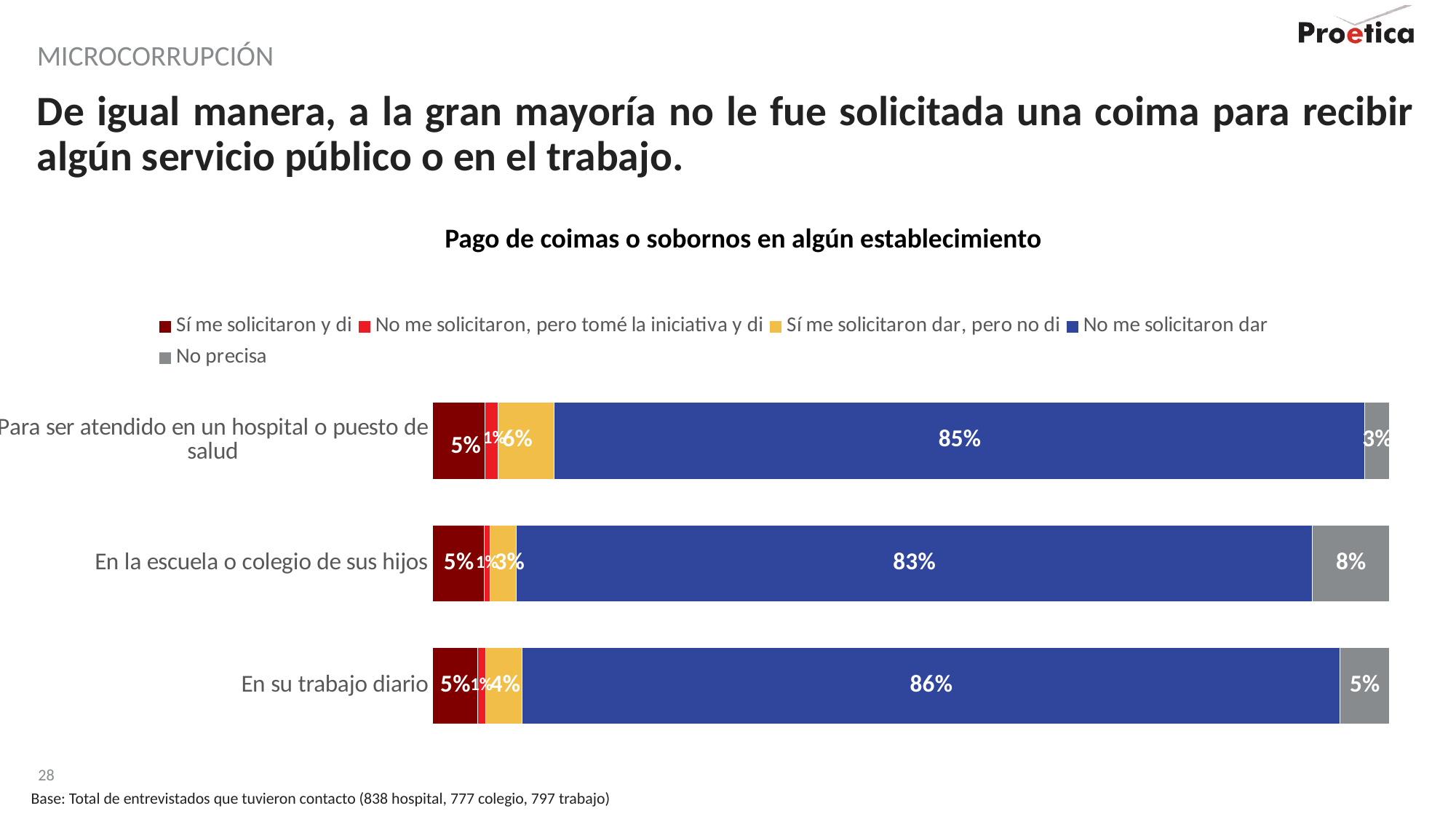
What is the title of the chart? Pago de coimas o sobornos en algún establecimiento What is the value of "No me solicitaron dar" for "Para ser atendido en un hospital o puesto de salud"? 85% What is the value of "No precisa" for "En la escuela o colegio de sus hijos"? 8% Which category has the lowest value for "No precisa"? Para ser atendido en un hospital o puesto de salud What is the difference between the "No me solicitaron dar" values for "En su trabajo diario" and "En la escuela o colegio de sus hijos"? 3% Which is larger: the "Sí me solicitaron dar, pero no di" value for "Para ser atendido en un hospital o puesto de salud" or for "En la escuela o colegio de sus hijos"? Para ser atendido en un hospital o puesto de salud What is the total of the stacked bar for "Para ser atendido en un hospital o puesto de salud"? 100% What is the value of "Sí me solicitaron dar, pero no di" for "En su trabajo diario"? 4% How many series does the legend list? 5 What type of chart is shown on the slide? Stacked bar chart Which category has the highest value for "No me solicitaron dar"? En su trabajo diario How many categories are shown in the chart? 3